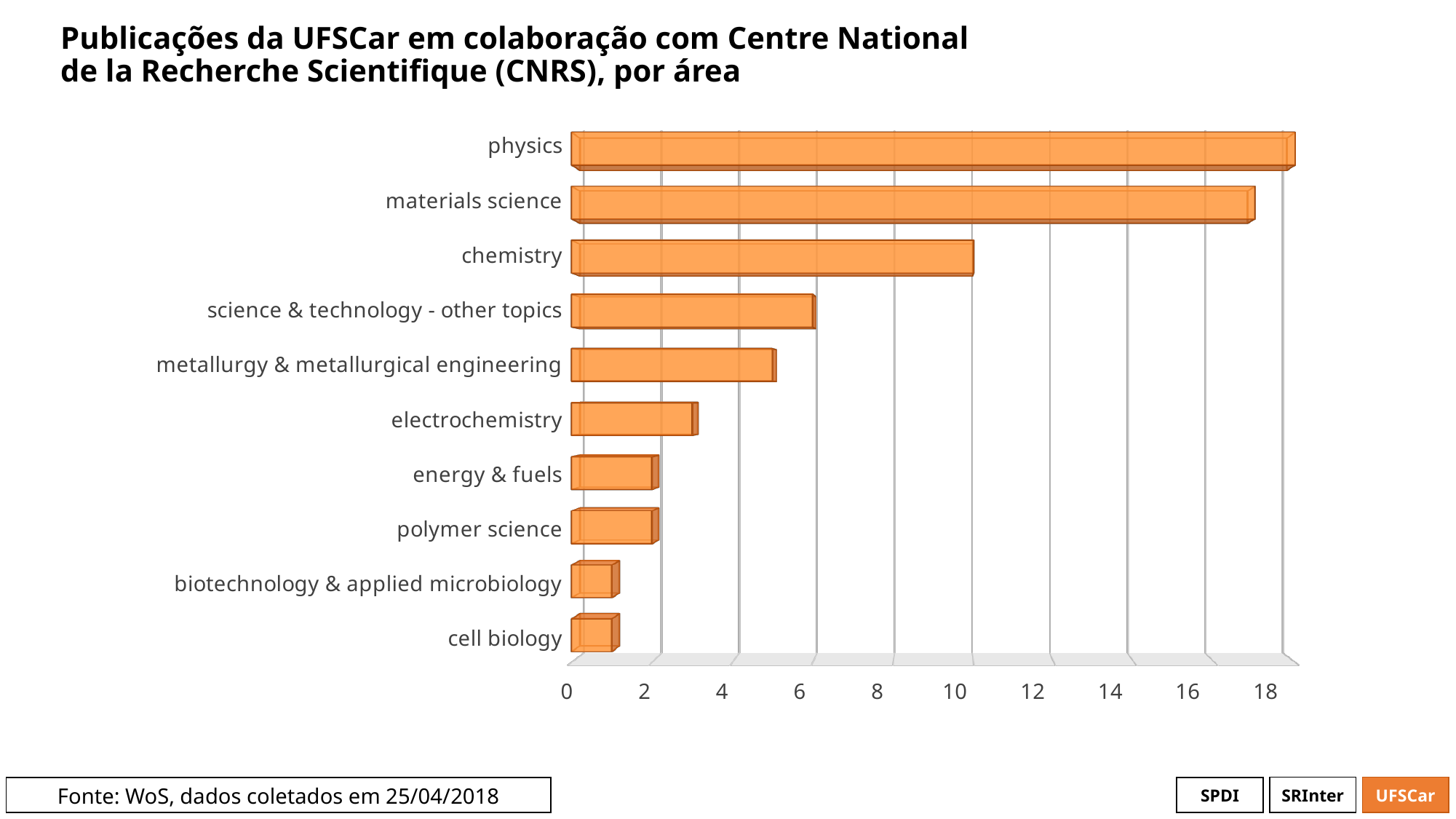
Is the value for chemistry greater or less than 8? greater Is the value for materials science greater or less than 14? greater Is the value for physics greater or less than 16? greater What kind of chart is shown on the slide? bar chart What is the data source cited at the bottom of the slide? WoS, dados coletados em 25/04/2018 How many areas (categories) are shown in the chart? 10 Which has more publications, physics or chemistry? physics Which area has the highest number of publications? physics Which has more publications, chemistry or electrochemistry? chemistry